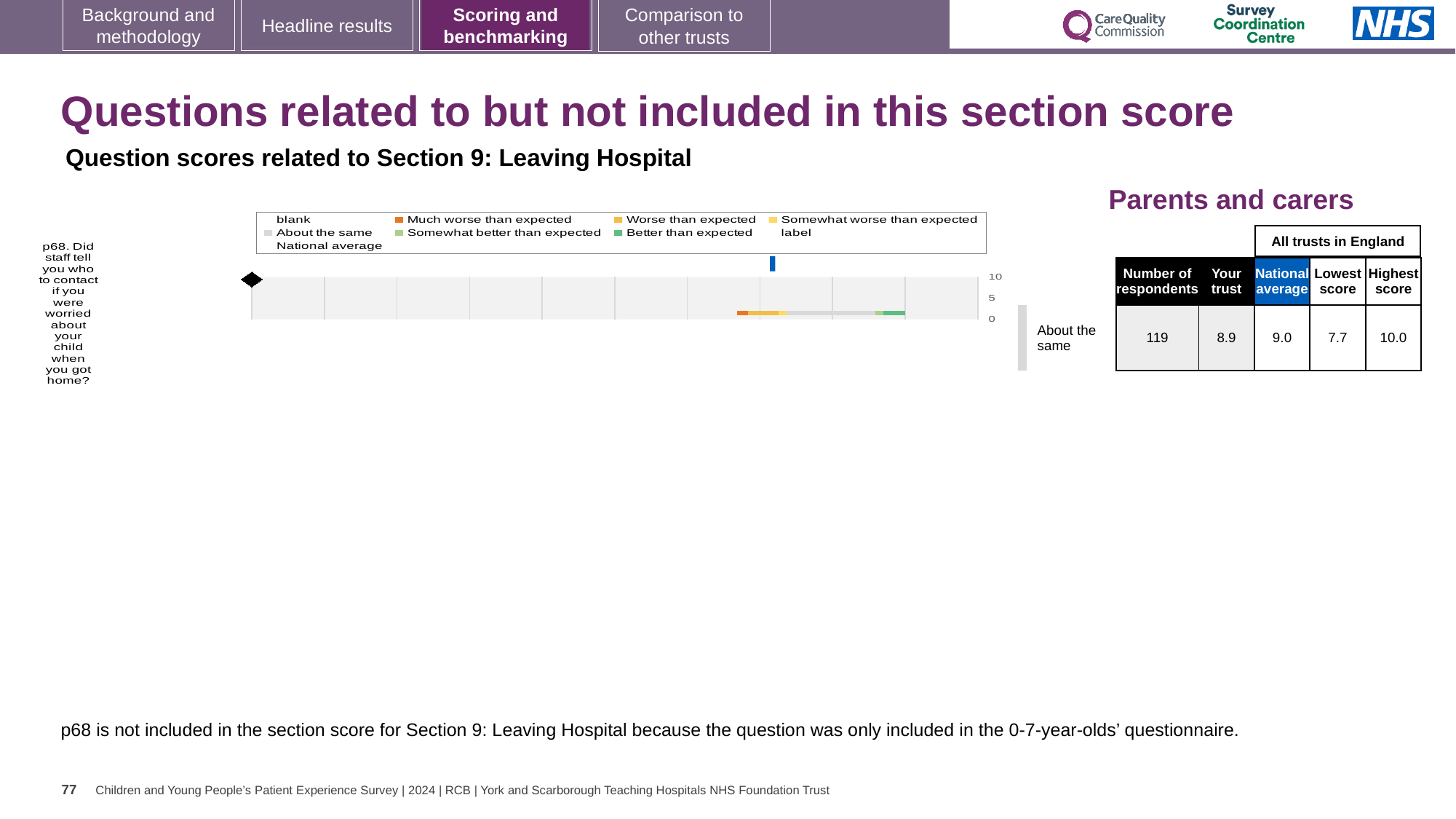
What colour represents 'Much worse than expected' in the chart legend? Orange What kind of chart is used to show the p68 question score? bar chart Which benchmark category is the trust's p68 result placed in? About the same What is the 'Your trust' score for p68? 8.9 What is the lowest score among all trusts in England for p68? 7.7 Is the 'Your trust' score for p68 greater or less than 5 on the chart's axis? greater What is the national average score for p68? 9.0 How many respondents answered p68? 119 What is the highest score among all trusts in England for p68? 10.0 How many questions are plotted in the chart? 1 Which is larger for p68, the 'Your trust' score or the national average? National average What is the difference between the highest score and the lowest score for p68? 2.3